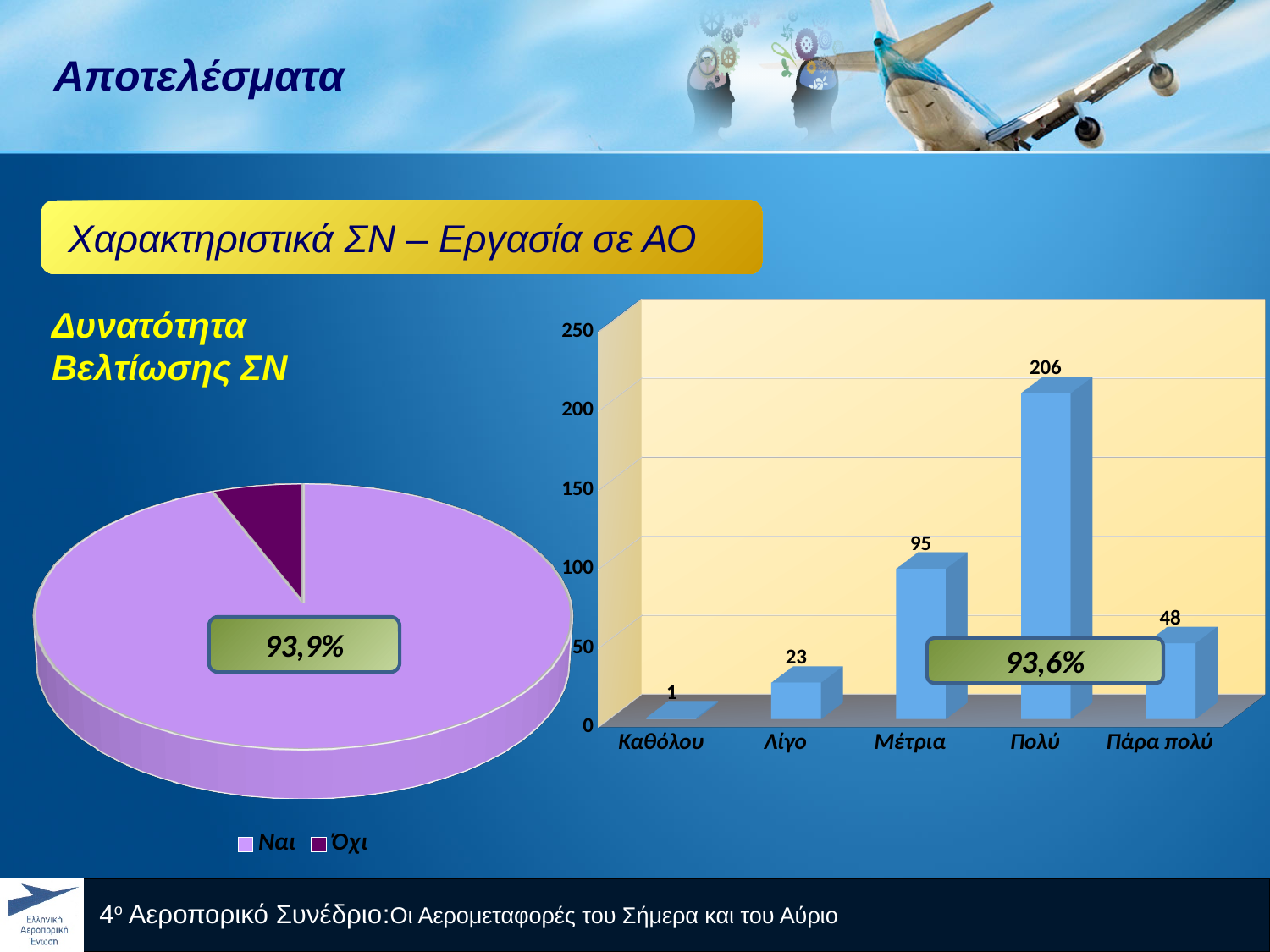
In the pie chart on the left, what share is shown for the Ναι slice? 93,9% How many entries does the legend of the pie chart on the left list? 2 In the bar chart on the right, what is the value for Λίγο? 23 In the bar chart on the right, what is the value for Πολύ? 206 In the bar chart on the right, which is larger, the value for Πάρα πολύ or the value for Λίγο? Πάρα πολύ In the bar chart on the right, what is the difference between the values for Πολύ and Μέτρια? 111 In the bar chart on the right, which category has the highest value? Πολύ In the bar chart on the right, which category has the lowest value? Καθόλου How many categories are shown on the x axis of the bar chart on the right? 5 In the bar chart on the right, what is the value for Μέτρια? 95 In the bar chart on the right, is the value for Πολύ greater or less than 200? greater What kind of chart is the chart on the left of the slide? pie chart